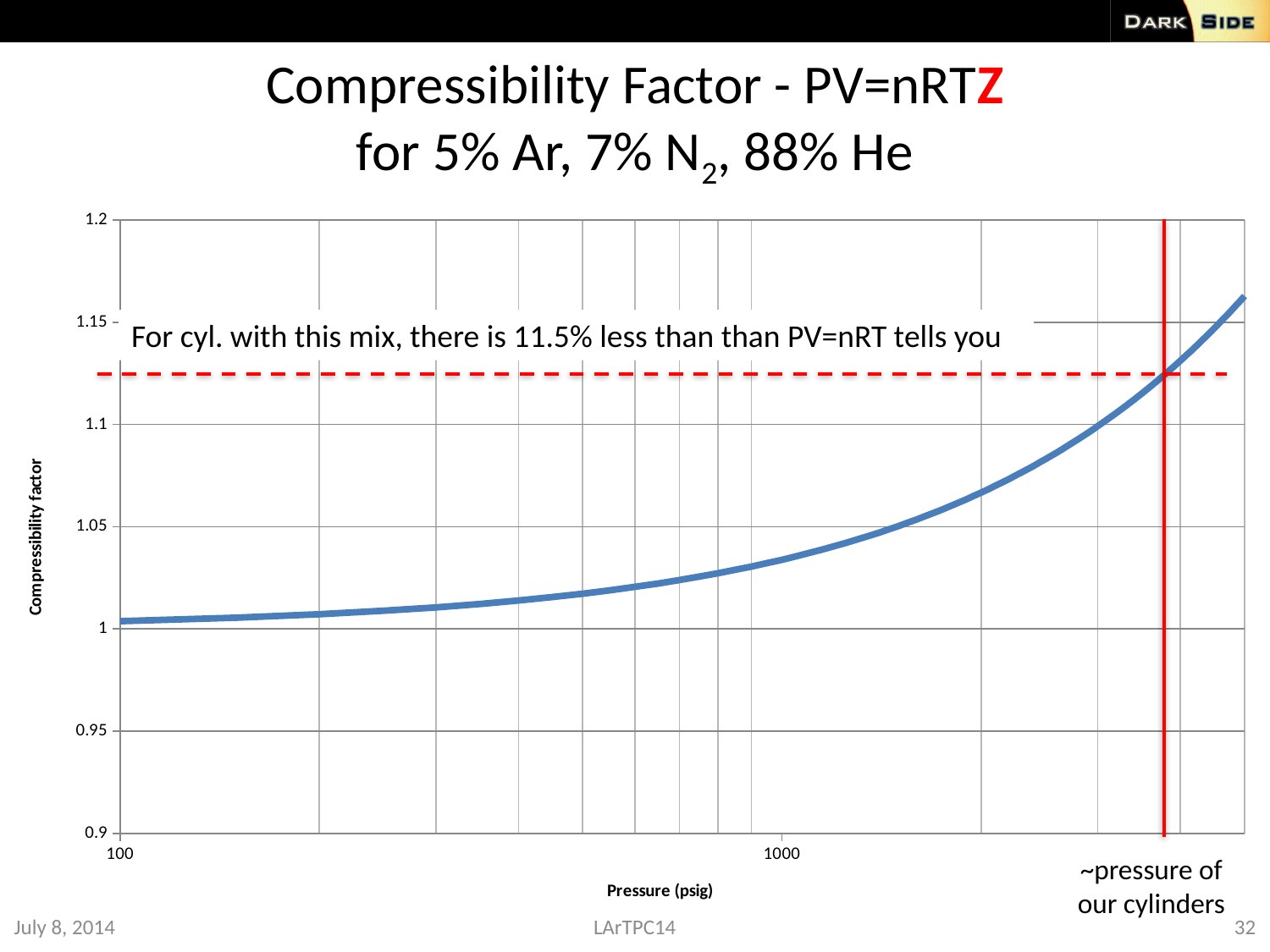
Is the compressibility factor at 1000 psig greater or less than 1? greater What kind of chart is shown on the slide? line chart What is the title of the chart on the slide? Compressibility Factor - PV=nRTZ for 5% Ar, 7% N2, 88% He Is the compressibility factor at 100 psig greater or less than 1.05? less Does the compressibility factor rise or fall as pressure increases along the x axis? rise Is the compressibility factor at 1000 psig greater or less than 1.05? less At which end of the pressure range is the compressibility factor lowest? 100 psig (the lowest pressure) What is the label of the x axis? Pressure (psig) Which is larger, the compressibility factor at 100 psig or at 1000 psig? at 1000 psig How many data series (lines) are plotted on the chart? 1